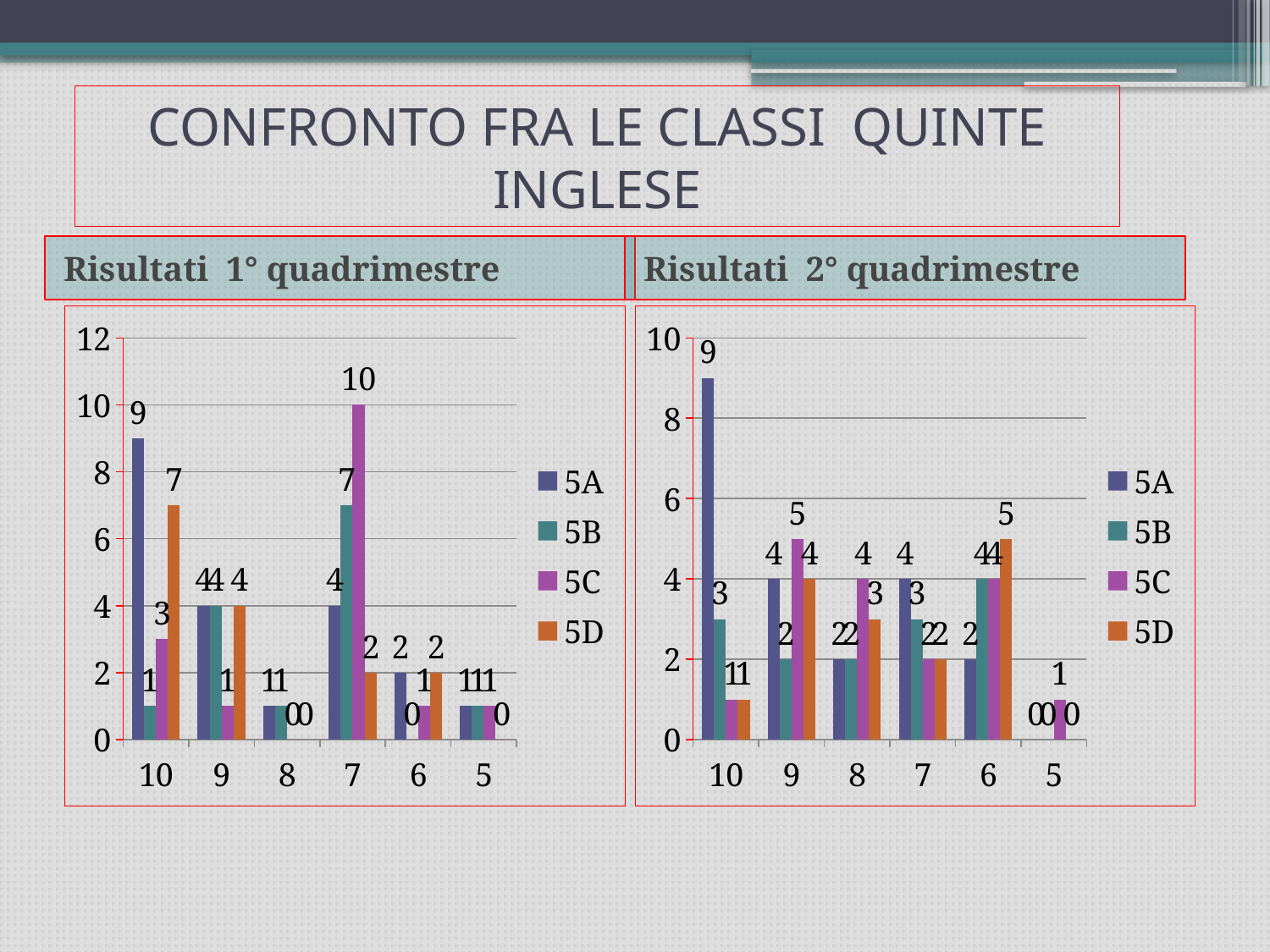
In the 'Risultati 1° quadrimestre' chart, what is the difference between the value for 5A and the value for 5D at grade 10? 2 In the 'Risultati 2° quadrimestre' chart, which is larger at grade 9: the value for 5C or the value for 5B? 5C What kind of chart is the 'Risultati 1° quadrimestre' chart? bar chart In the 'Risultati 2° quadrimestre' chart, what is the value for 5A at grade 10? 9 In the 'Risultati 2° quadrimestre' chart, which series has the highest value at grade 10? 5A In the 'Risultati 1° quadrimestre' chart, what is the value for 5C at grade 7? 10 How many series does the legend of the 'Risultati 2° quadrimestre' chart list? 4 What are the legend entries of the 'Risultati 1° quadrimestre' chart? 5A, 5B, 5C, 5D In the 'Risultati 1° quadrimestre' chart, what is the value for 5A at grade 10? 9 In the 'Risultati 2° quadrimestre' chart, what is the value for 5D at grade 6? 5 How many grade categories are shown on the x axis of the 'Risultati 1° quadrimestre' chart? 6 In the 'Risultati 1° quadrimestre' chart, which series has the highest value at grade 7? 5C